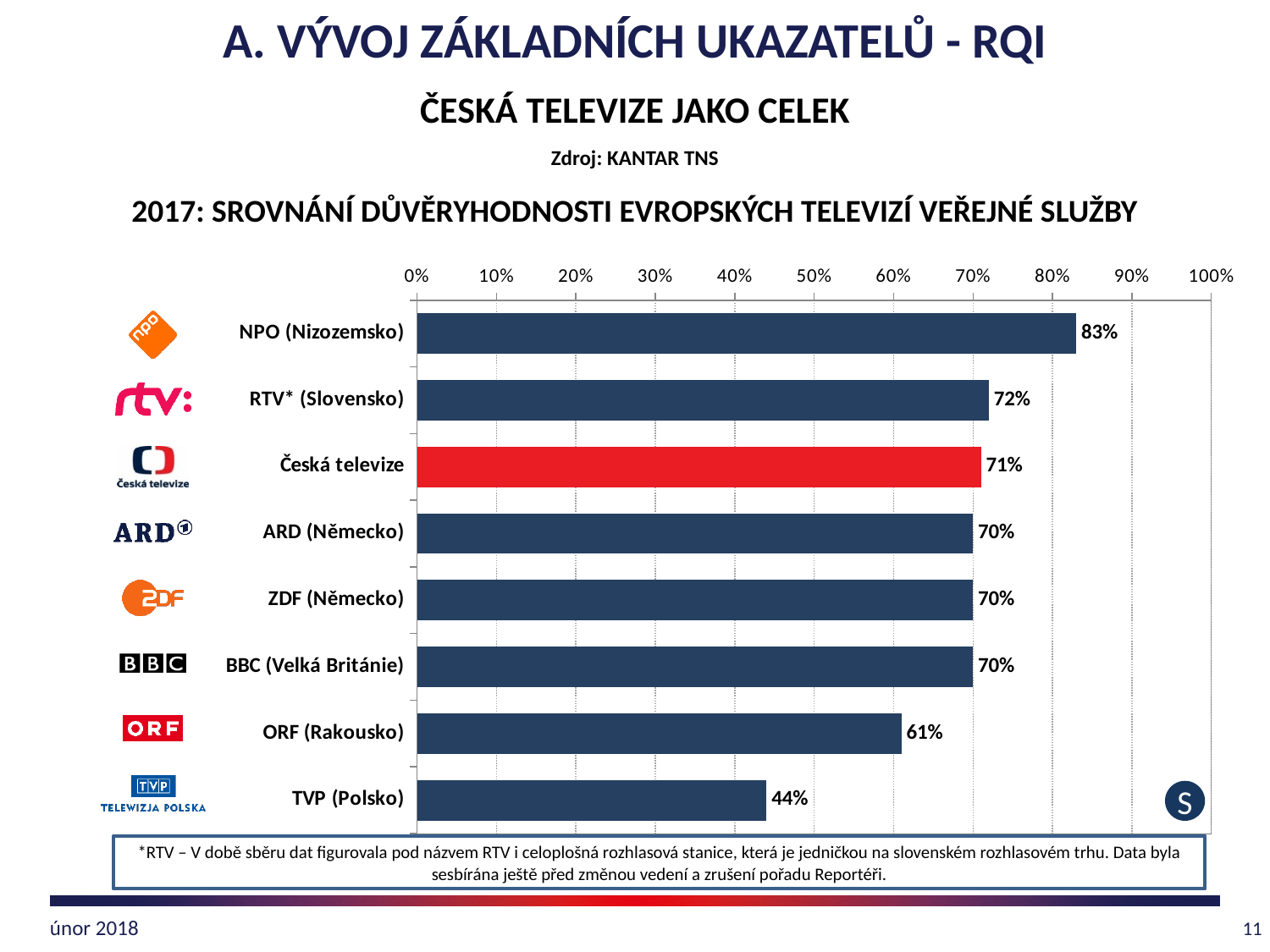
What is the difference between the values for NPO (Nizozemsko) and TVP (Polsko)? 39% What kind of chart is shown on the slide? Bar chart Which broadcaster has the lowest value? TVP (Polsko) Which bar is coloured red instead of dark blue? Česká televize What is the difference between the values for RTV* (Slovensko) and ORF (Rakousko)? 11% What is the value for Česká televize? 71% Which is larger, the value for Česká televize or the value for ORF (Rakousko)? Česká televize What is the value for TVP (Polsko)? 44% Which broadcaster has the highest value? NPO (Nizozemsko) What is the value for NPO (Nizozemsko)? 83% What is the value for ORF (Rakousko)? 61% How many broadcasters are shown in the chart? 8